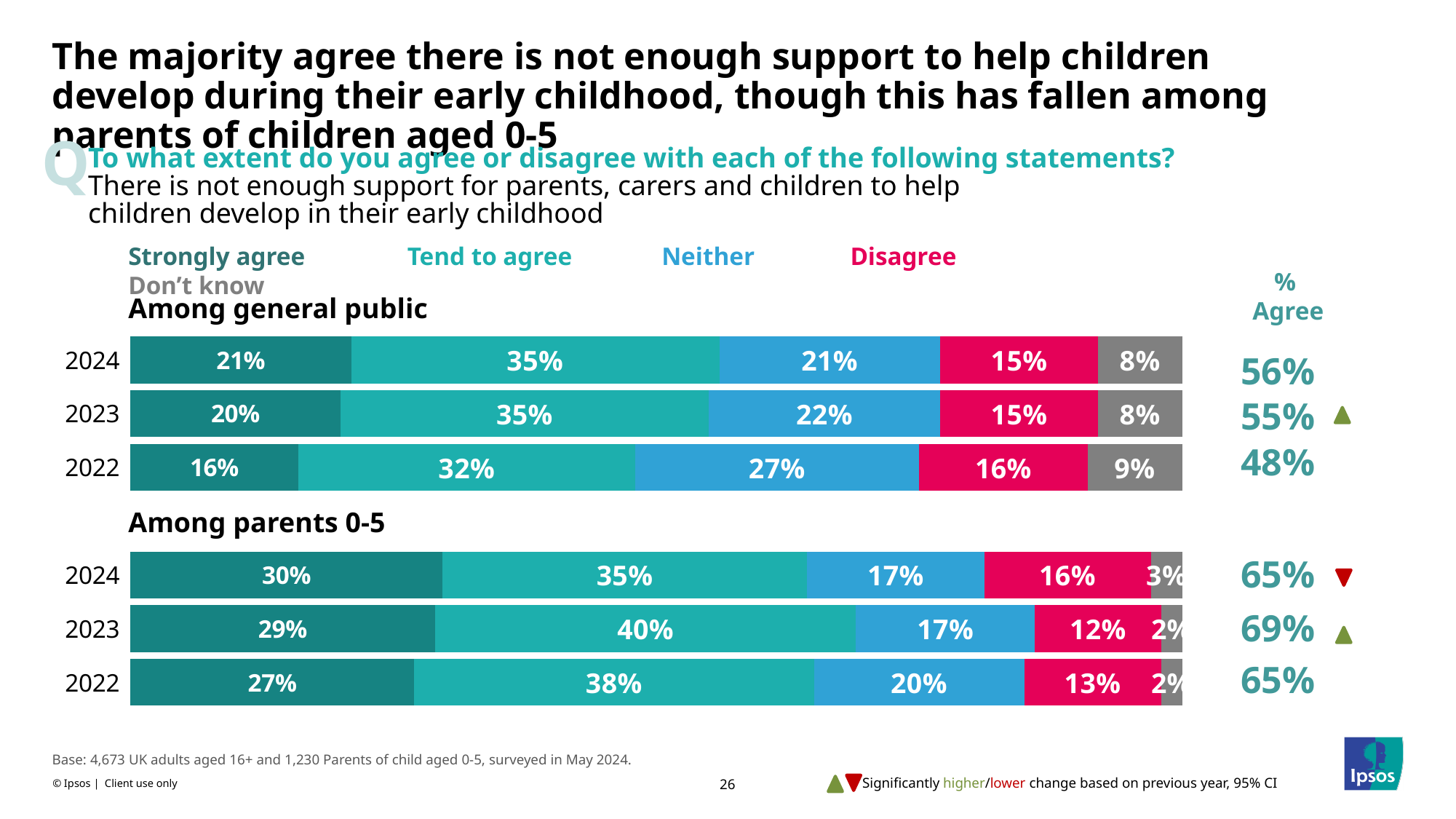
In the 'Among general public' chart, what percentage strongly agreed in 2024? 21% How many series does the legend list? 5 In the 'Among general public' chart, what is the difference between the % Agree figures for 2024 and 2022? 8 percentage points In the 'Among parents 0-5' chart, what percentage tended to agree in 2023? 40% In the 'Among parents 0-5' chart, what percentage answered 'Neither' in 2022? 20% In the 'Among parents 0-5' chart, what is the difference between the 'Disagree' percentages for 2024 and 2023? 4 percentage points Is the 'Strongly agree' percentage for 2024 larger in the 'Among general public' chart or the 'Among parents 0-5' chart? Among parents 0-5 In the 'Among parents 0-5' chart, which year has the highest % Agree figure? 2023 In the 'Among general public' chart, how many years are shown? 3 What kind of chart is used to show the responses? Stacked bar chart In the 'Among general public' chart, what is the % Agree figure for 2022? 48% In the 'Among general public' chart, which year has the lowest 'Strongly agree' percentage? 2022